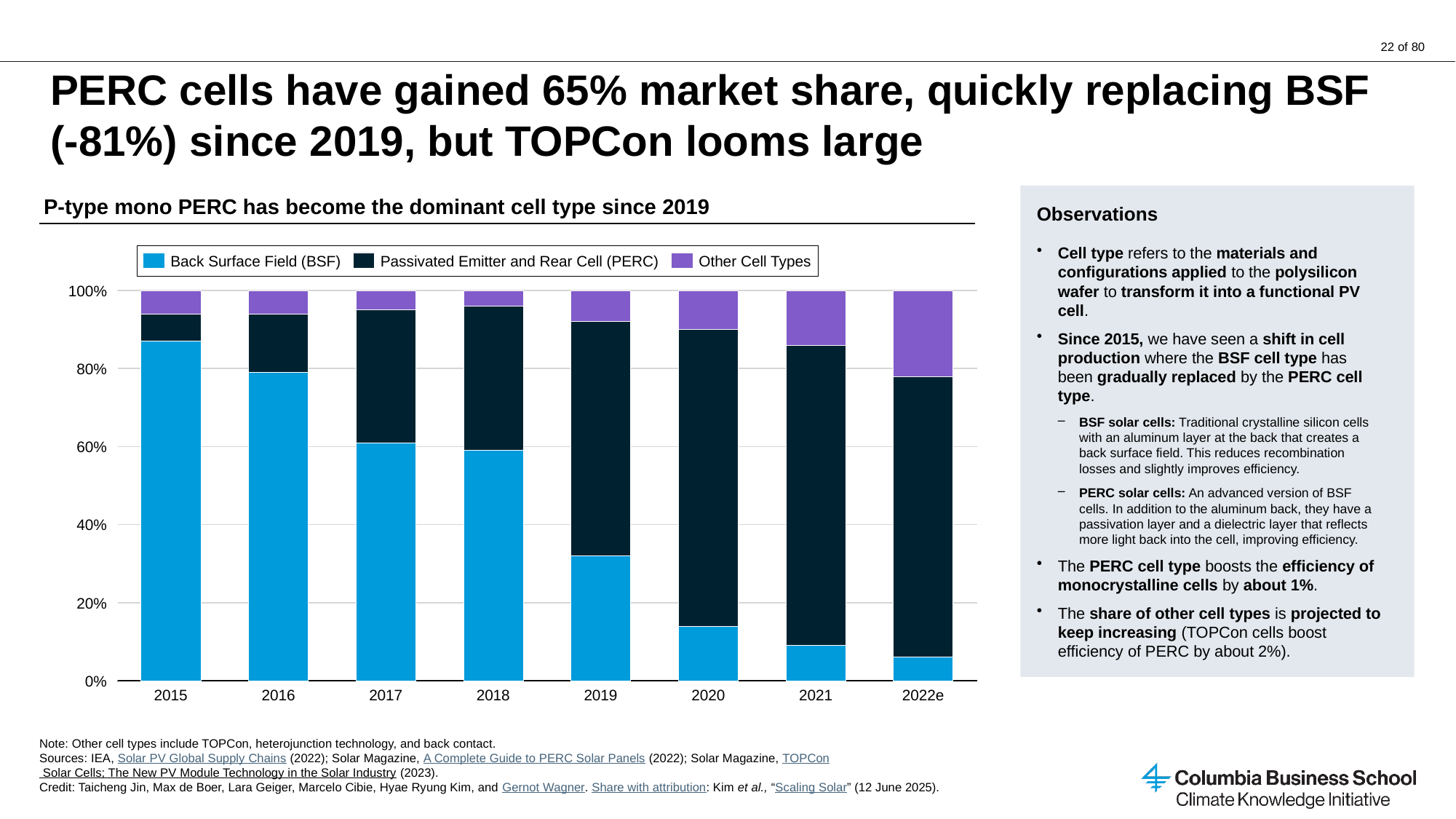
What is the title of the chart? P-type mono PERC has become the dominant cell type since 2019 How many years are shown along the x axis of the chart? 8 Is the Back Surface Field (BSF) share in 2015 greater or less than 80%? greater In which year is the Back Surface Field (BSF) share the lowest? 2022e How many series does the chart legend list? 3 Which is larger in 2020, the Back Surface Field (BSF) share or the Passivated Emitter and Rear Cell (PERC) share? Passivated Emitter and Rear Cell (PERC) Is the Back Surface Field (BSF) share in 2021 greater or less than 20%? less In which year is the Other Cell Types share the largest? 2022e What kind of chart is shown on the slide? Stacked bar chart Does the Back Surface Field (BSF) share rise or fall from 2015 to 2022e? Fall In which year is the Back Surface Field (BSF) share the highest? 2015 Is the Back Surface Field (BSF) share in 2019 greater or less than 40%? less